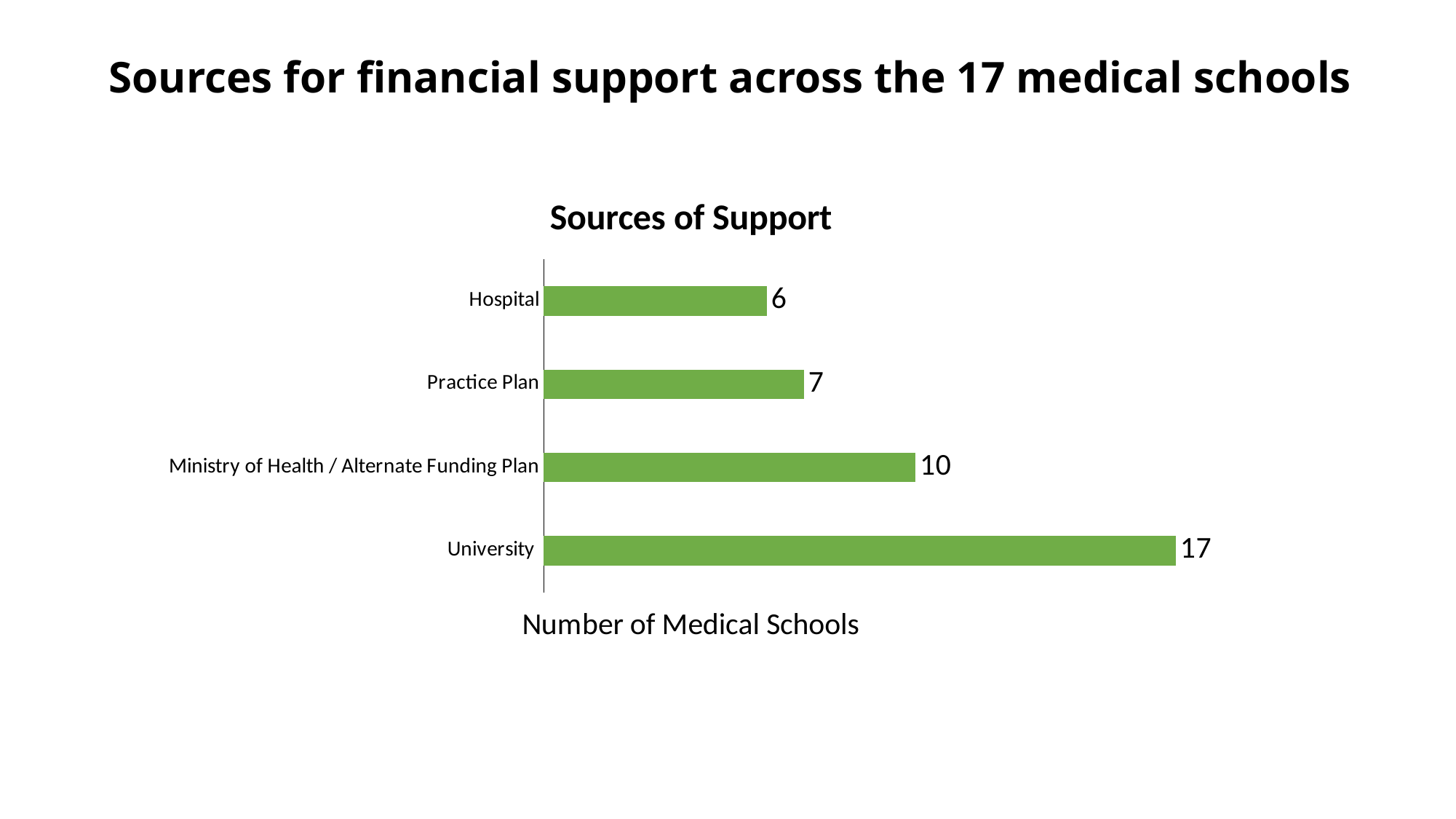
What is the difference between the values for University and Ministry of Health / Alternate Funding Plan? 7 How many categories are shown in the chart? 4 What is the value for Ministry of Health / Alternate Funding Plan? 10 What is the title of the chart? Sources of Support Which source of support has the highest number of medical schools? University Which source of support has the lowest number of medical schools? Hospital What is the value for Hospital? 6 Which is larger, the value for Ministry of Health / Alternate Funding Plan or the value for Practice Plan? Ministry of Health / Alternate Funding Plan What kind of chart is shown on the slide? Bar chart What is the value for Practice Plan? 7 What is the difference between the values for Practice Plan and Hospital? 1 What is the value for University? 17